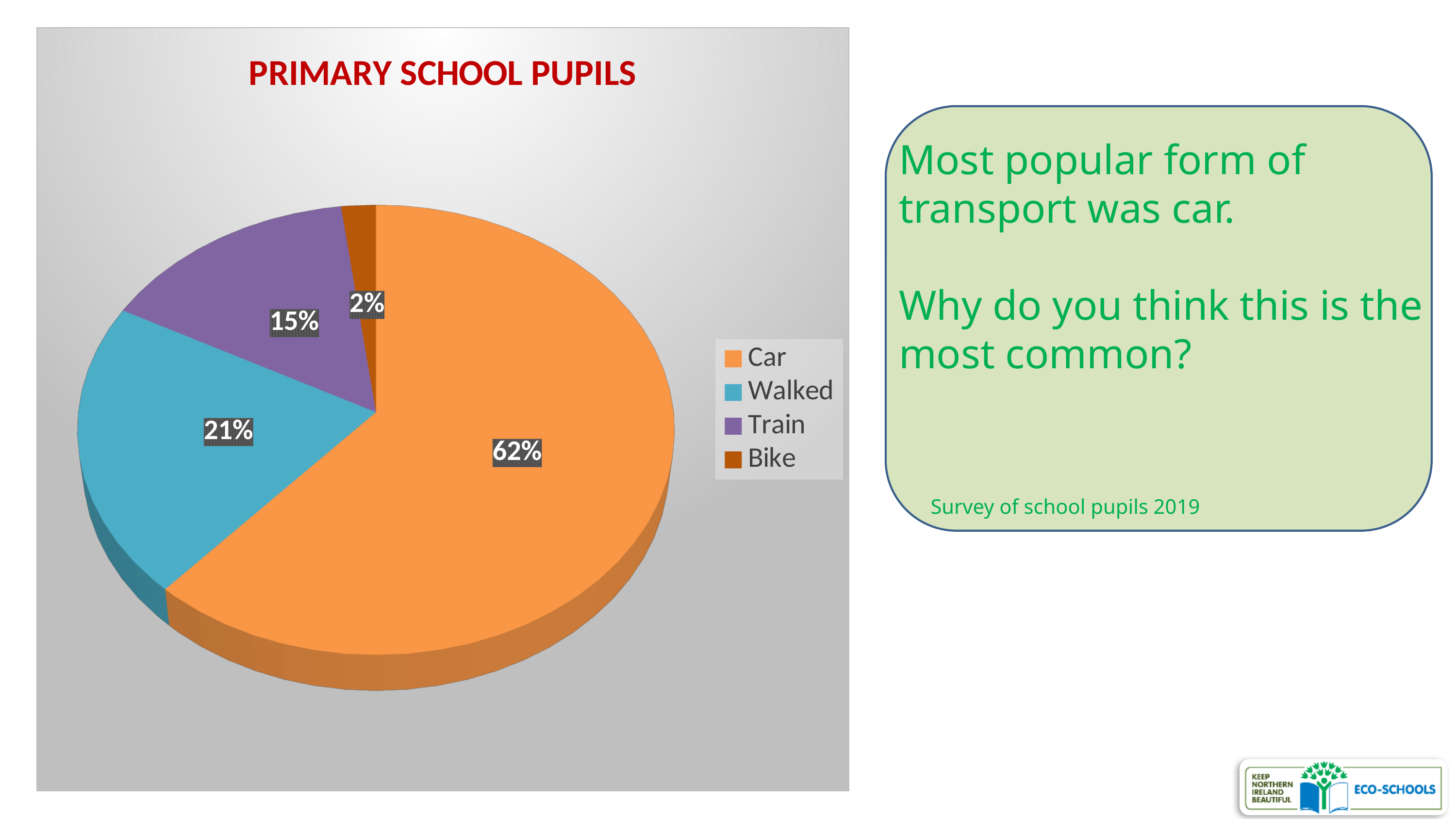
Which form of transport has the smallest share of the pie? Bike How many categories are shown in the pie chart? 4 What percentage of primary school pupils travelled by car? 62% What kind of chart is shown on the slide? Pie chart What percentage of primary school pupils travelled by train? 15% What percentage of primary school pupils travelled by bike? 2% What is the difference in percentage points between Walked and Train? 6 What percentage of primary school pupils walked? 21% What is the title of the chart? PRIMARY SCHOOL PUPILS Which form of transport has the largest share of the pie? Car What is the difference in percentage points between Car and Walked? 41 Which has a larger share, Train or Walked? Walked